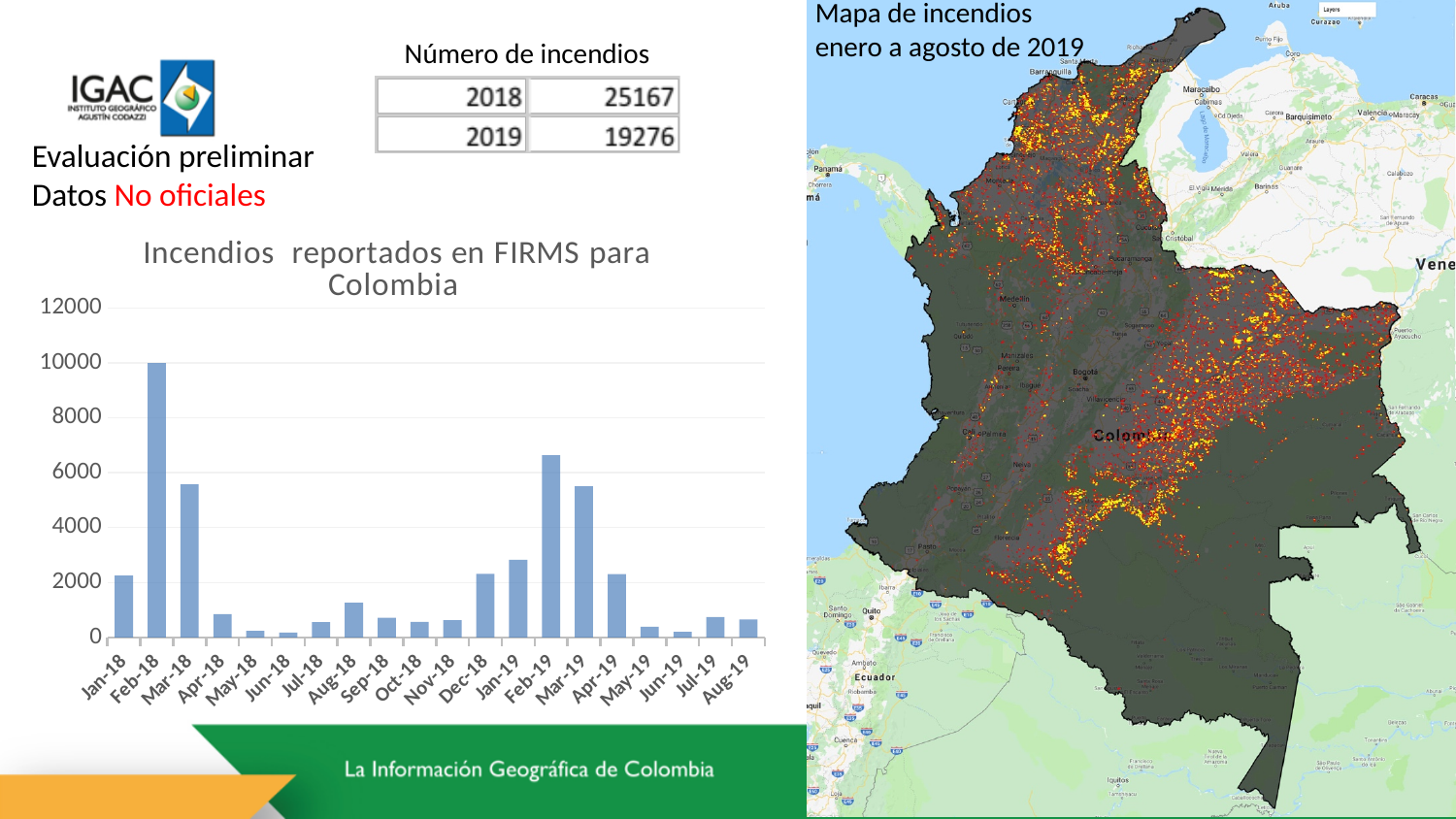
What is the title of the chart on the left of the slide? Incendios reportados en FIRMS para Colombia In the chart 'Incendios reportados en FIRMS para Colombia', which is larger, the value for Jan-18 or Jan-19? Jan-19 In the chart 'Incendios reportados en FIRMS para Colombia', is the value for Apr-18 greater or less than 2000? less In the chart 'Incendios reportados en FIRMS para Colombia', do the values rise or fall from Feb-18 to Jun-18? fall In the chart 'Incendios reportados en FIRMS para Colombia', is the value for Mar-18 greater or less than 4000? greater What type of chart is 'Incendios reportados en FIRMS para Colombia'? bar chart In the chart 'Incendios reportados en FIRMS para Colombia', is the value for Feb-19 greater or less than 6000? greater How many months (bars) are shown in the chart 'Incendios reportados en FIRMS para Colombia'? 20 In the chart 'Incendios reportados en FIRMS para Colombia', which is larger, the value for Feb-18 or Feb-19? Feb-18 In the chart 'Incendios reportados en FIRMS para Colombia', which month has the highest number of fires? Feb-18